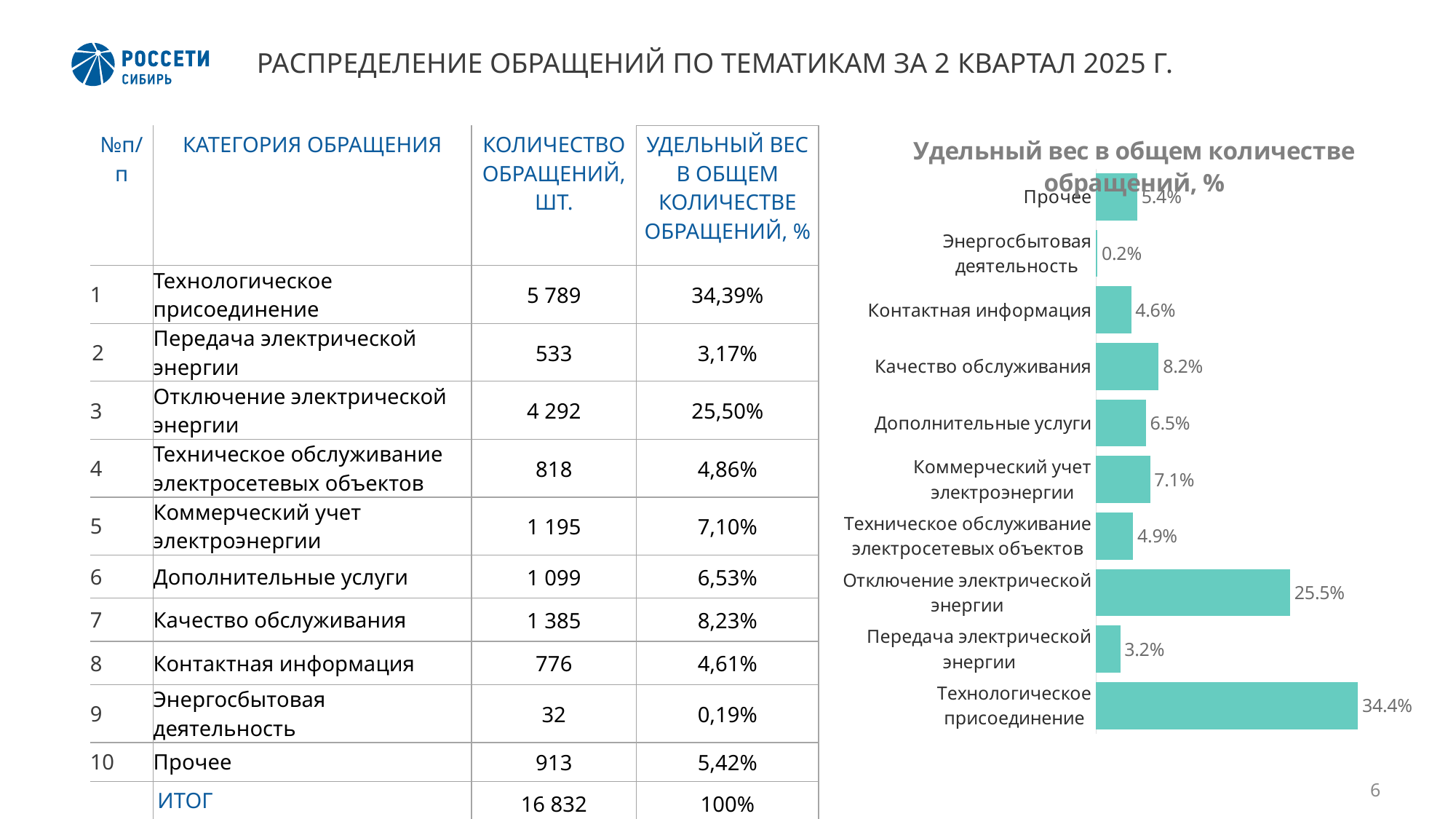
What is the value for Отключение электрической энергии in the chart? 25.5% Which is larger in the chart: Прочее or Передача электрической энергии? Прочее Which category has the highest value in the chart? Технологическое присоединение How many categories are shown in the chart? 10 What is the title of the chart? Удельный вес в общем количестве обращений, % What is the difference between the values for Технологическое присоединение and Отключение электрической энергии in the chart? 8.9% Which category has the lowest value in the chart? Энергосбытовая деятельность What is the value for Качество обслуживания in the chart? 8.2% What is the value for Энергосбытовая деятельность in the chart? 0.2% What kind of chart is shown on the slide? Bar chart What is the value for Технологическое присоединение in the chart? 34.4% Which is larger in the chart: Коммерческий учет электроэнергии or Дополнительные услуги? Коммерческий учет электроэнергии